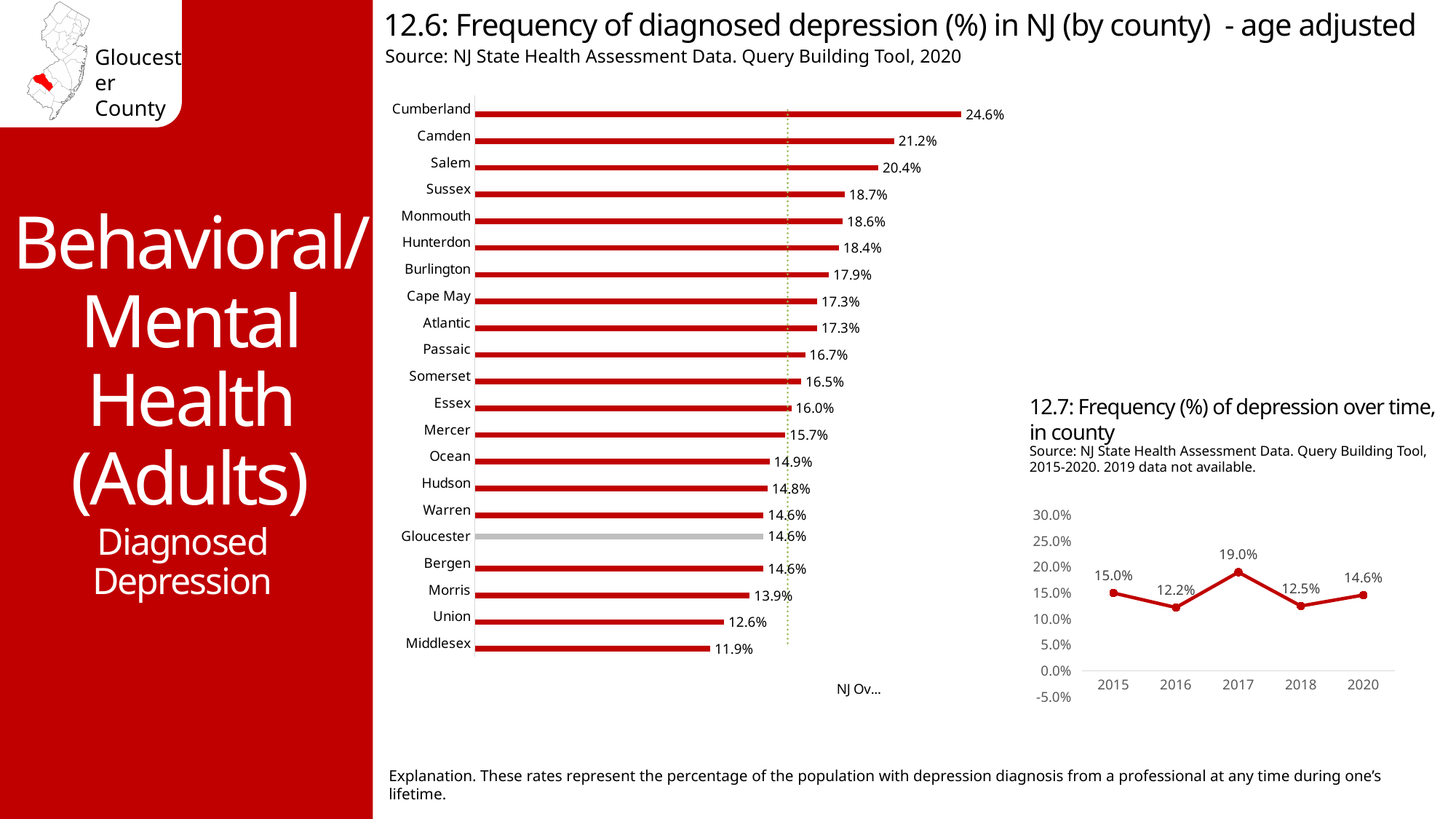
In chart 12.7 (frequency of depression over time), which year has the lowest value? 2016 In chart 12.6 (frequency of diagnosed depression by county), what is the value for Gloucester? 14.6% In chart 12.6 (frequency of diagnosed depression by county), how many counties are plotted? 21 In chart 12.6 (frequency of diagnosed depression by county), which county has the lowest value? Middlesex In chart 12.6 (frequency of diagnosed depression by county), which county has the highest value? Cumberland In chart 12.7 (frequency of depression over time), what is the difference between 2017 and 2018? 6.5% What kind of chart is chart 12.7 (frequency of depression over time)? Line chart In chart 12.6 (frequency of diagnosed depression by county), which is larger, Passaic or Somerset? Passaic What kind of chart is chart 12.6 (frequency of diagnosed depression by county)? Bar chart In chart 12.7 (frequency of depression over time), what is the value for 2017? 19.0% In chart 12.6 (frequency of diagnosed depression by county), what is the difference between Camden and Salem? 0.8% In chart 12.6 (frequency of diagnosed depression by county), what is the value for Cumberland? 24.6%